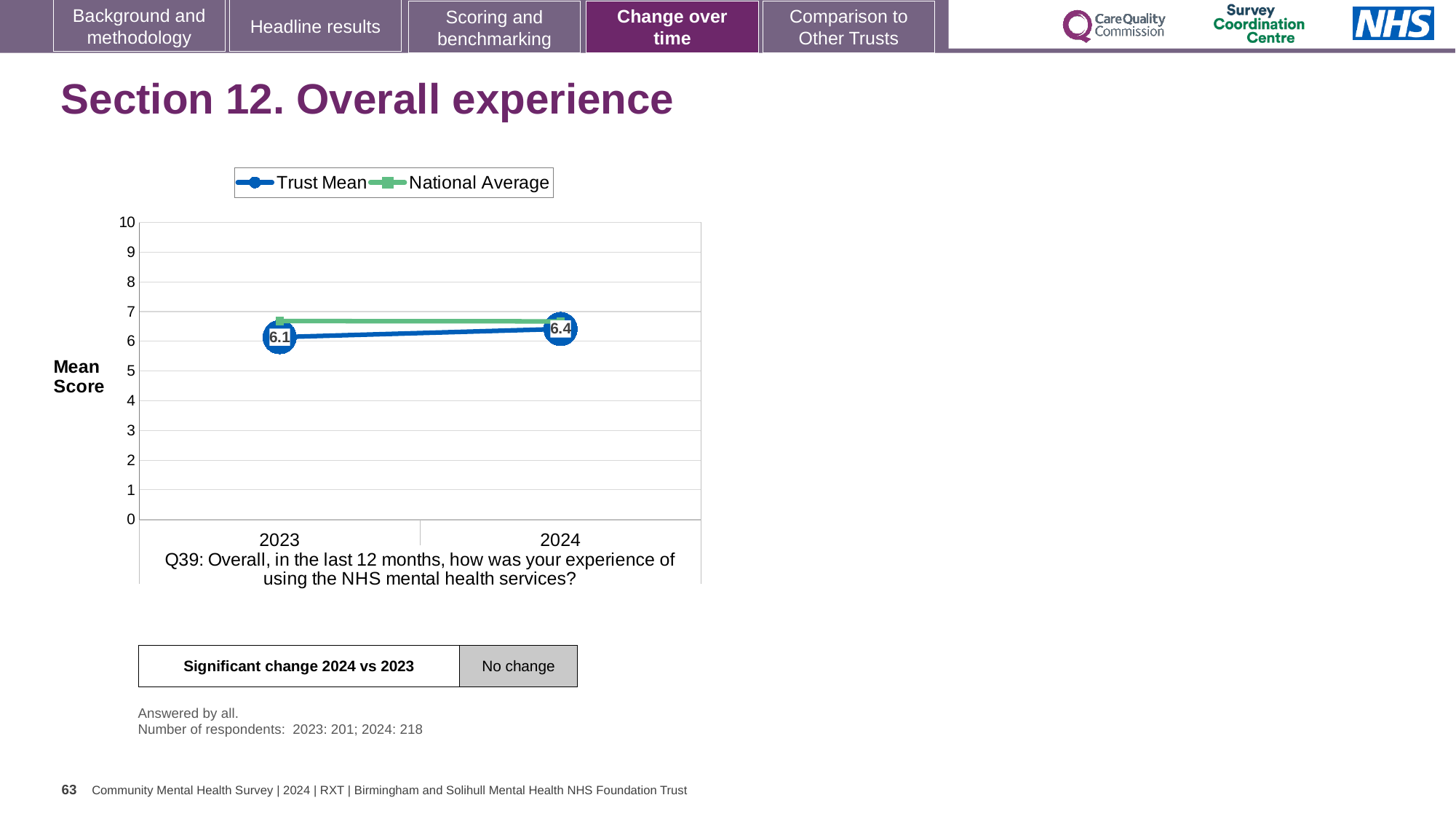
How many series does the legend list? 2 By how much did the Trust Mean change from 2023 to 2024? 0.3 What is the Trust Mean score for 2024? 6.4 In 2023, which was higher: the Trust Mean or the National Average? National Average In which year was the Trust Mean higher? 2024 Is the National Average for 2024 greater or less than 7? less What is the Trust Mean score for 2023? 6.1 Did the Trust Mean rise or fall from 2023 to 2024? rise Is the National Average for 2023 greater or less than 6? greater What type of chart is shown? line chart How many years are plotted on the x axis? 2 In which year was the Trust Mean lower? 2023